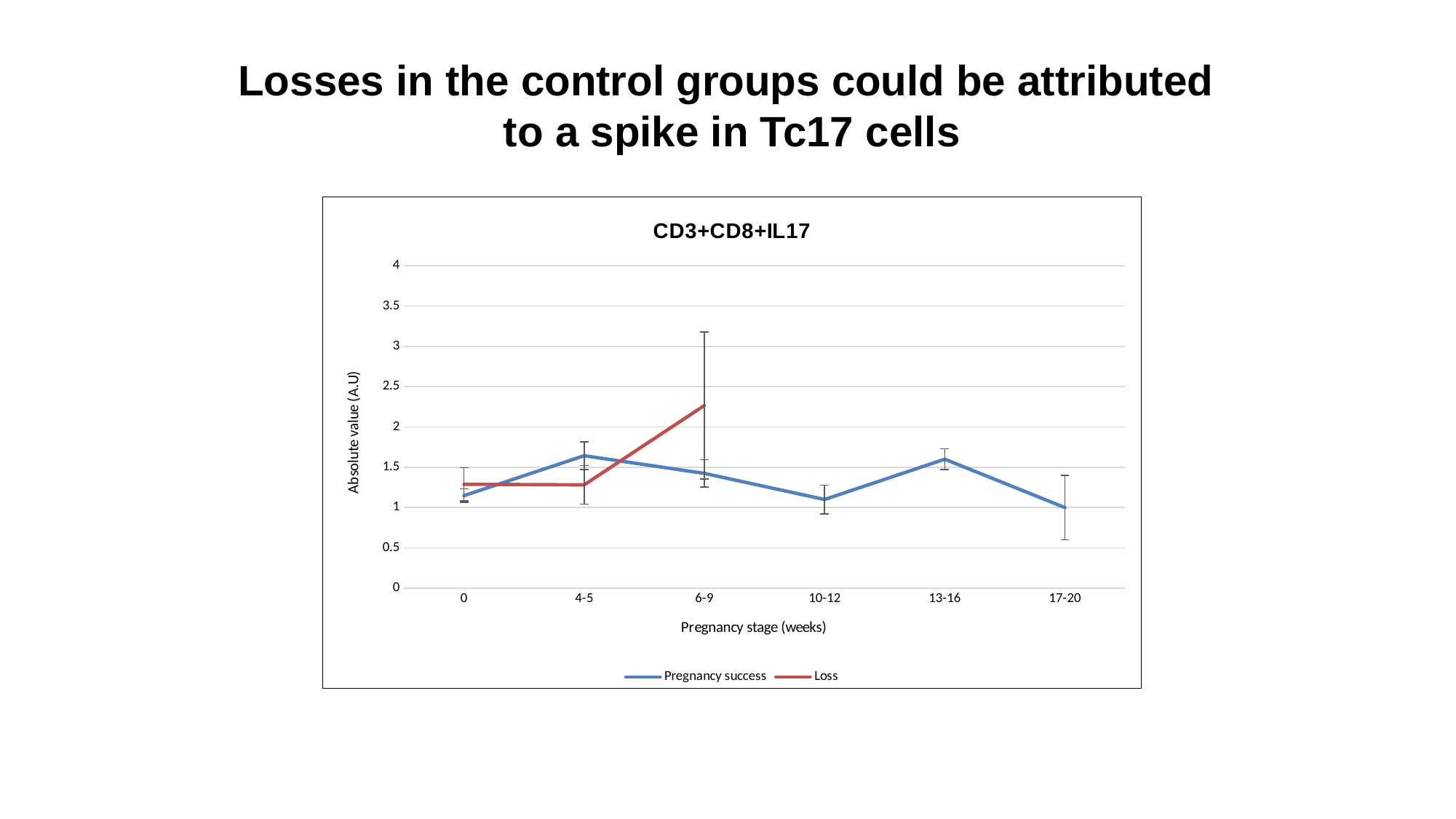
At which pregnancy stage does the Loss series reach its highest value? 6-9 Is the value for Loss at 6-9 weeks greater or less than 2? greater Is the value for Pregnancy success at 4-5 weeks greater or less than 1.5? greater What is the title of the chart? CD3+CD8+IL17 Is the value for Pregnancy success at 10-12 weeks greater or less than 1.5? less At 4-5 weeks, which series has the larger value, Pregnancy success or Loss? Pregnancy success What kind of chart is shown on the slide? Line chart Does the Loss series rise or fall between 4-5 weeks and 6-9 weeks? Rise How many pregnancy stage categories are shown on the x axis? 6 How many series does the legend list? 2 At 6-9 weeks, which series has the larger value, Pregnancy success or Loss? Loss What is the label of the y axis? Absolute value (A.U)